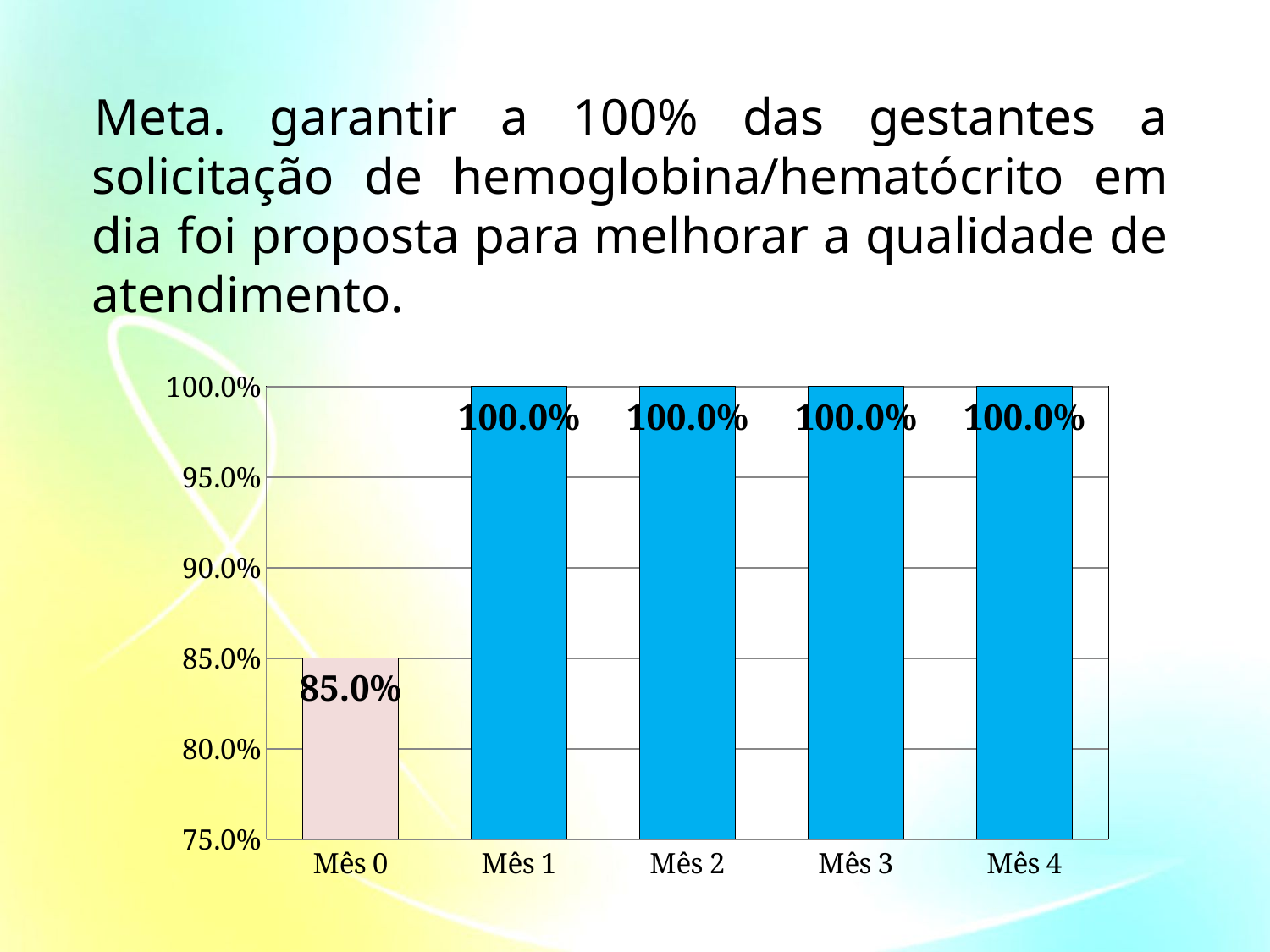
How many categories have a value of 100.0%? 4 Do the values rise or fall from Mês 0 to Mês 1? rise How many categories are shown on the x axis? 5 Which category has the lowest value? Mês 0 What is the value for Mês 1? 100.0% Is the value for Mês 0 greater or less than 90.0%? less What is the difference between the values for Mês 1 and Mês 0? 15.0% What colour is the bar for Mês 0? light pink What is the value for Mês 0? 85.0% Which is larger, the value for Mês 0 or the value for Mês 2? Mês 2 What is the value for Mês 4? 100.0% What kind of chart is shown on the slide? bar chart